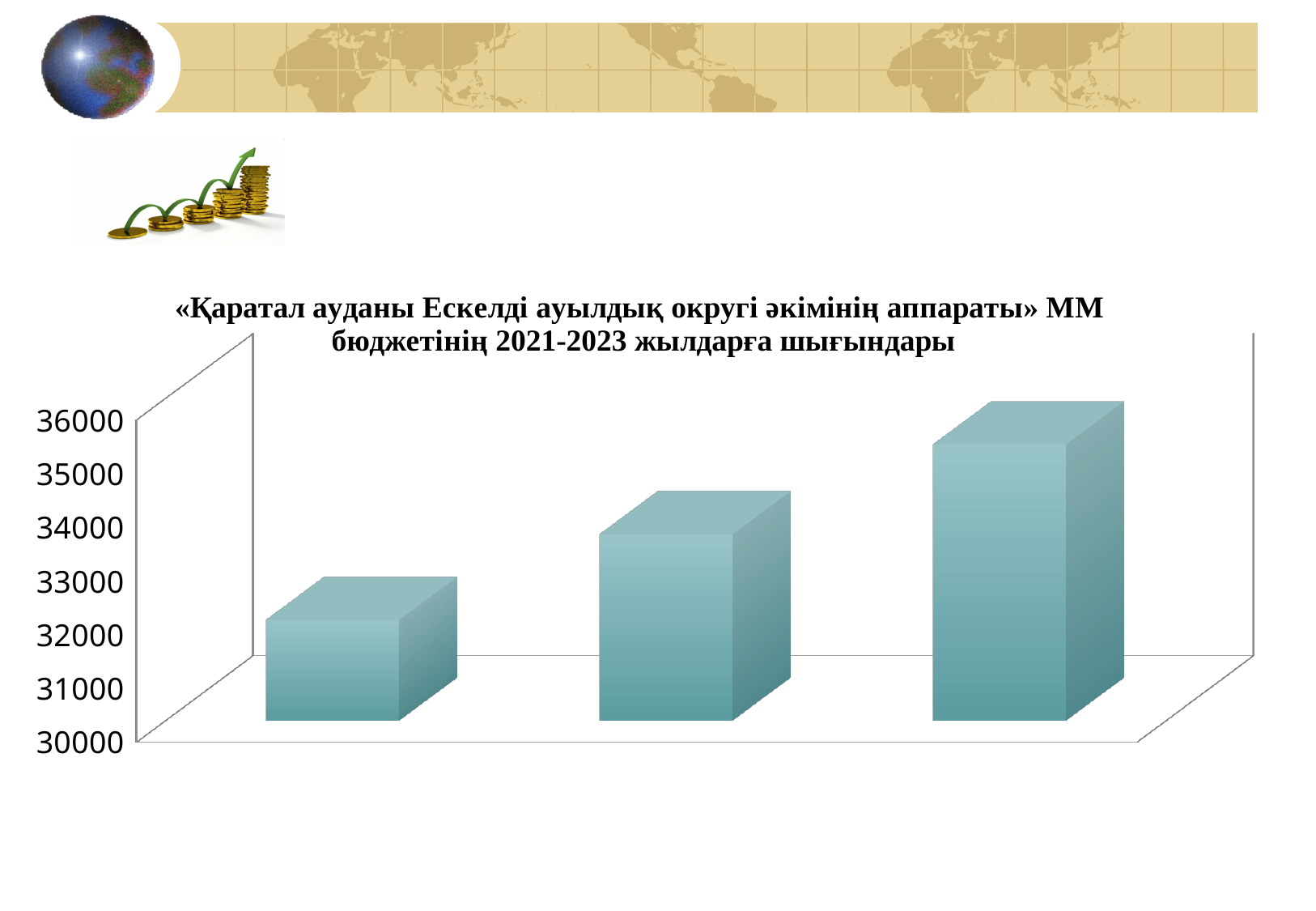
Do the bar values rise or fall from left to right across the chart? rise Is the value of the right bar greater or less than 34000? greater What is the lowest value shown on the vertical axis of the chart? 30000 Which is larger, the middle bar or the left bar? the middle bar Is the value of the left bar greater or less than 33000? less Which bar is the shortest: the left, middle or right one? left Which years does the chart title say the budget expenditures cover? 2021-2023 Is the value of the middle bar greater or less than 35000? less How many bars are plotted in the chart? 3 Which bar is the tallest: the left, middle or right one? right What kind of chart is shown on the slide? bar chart